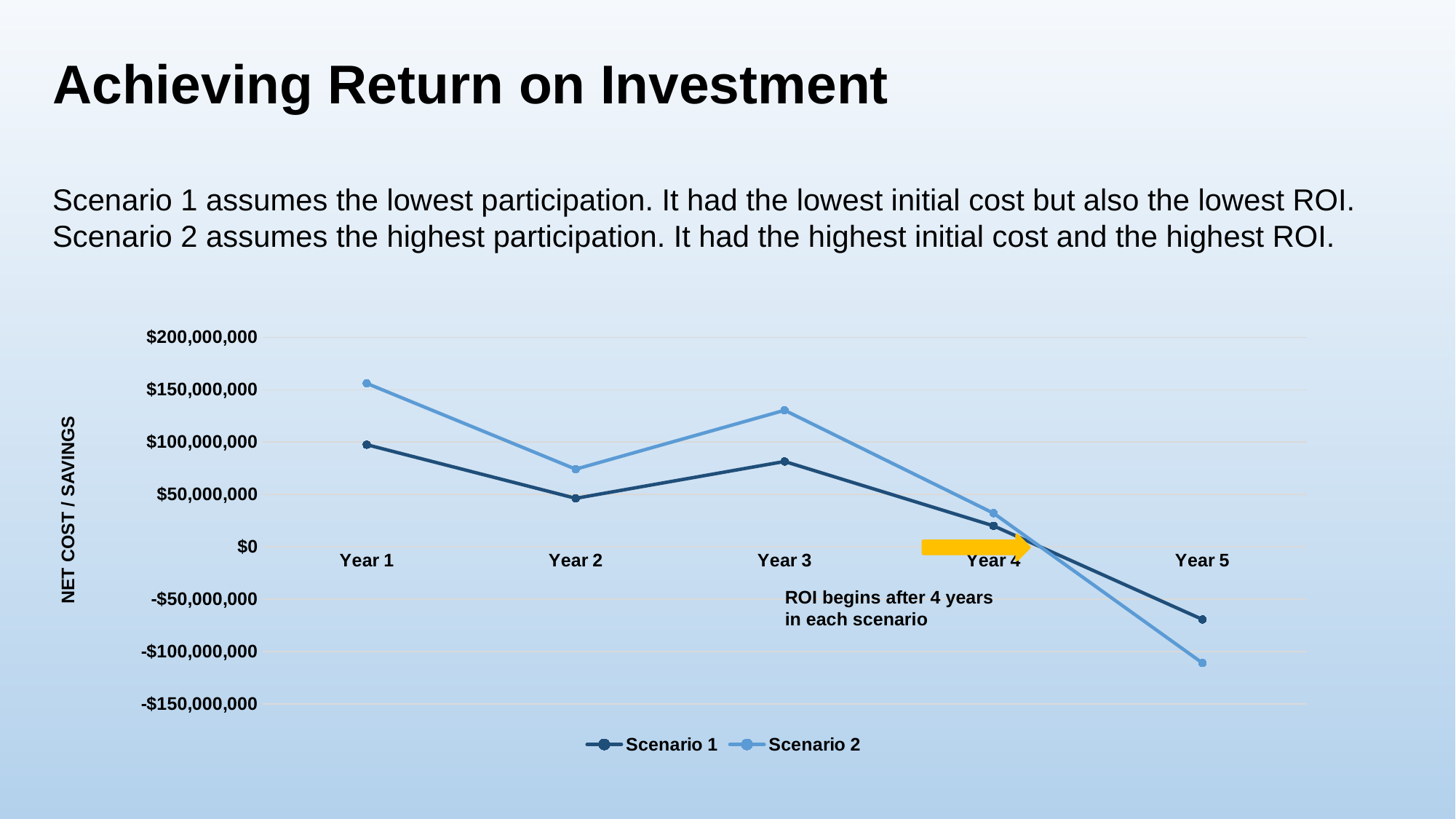
What is the title of the chart's vertical axis? NET COST / SAVINGS Is the value for Scenario 2 in Year 5 greater or less than -$100,000,000? less In which year does Scenario 1 reach its lowest value? Year 5 Is the value for Scenario 2 in Year 1 greater or less than $100,000,000? greater In Year 5, which series has the higher value, Scenario 1 or Scenario 2? Scenario 1 In which year does Scenario 2 reach its highest value? Year 1 How many years are plotted along the x axis of the chart? 5 What kind of chart is shown on the slide? line chart Is the value for Scenario 1 in Year 3 greater or less than $50,000,000? greater Overall, do the values for Scenario 2 rise or fall from Year 1 to Year 5? fall How many series does the chart legend list? 2 In Year 3, which series has the higher value, Scenario 1 or Scenario 2? Scenario 2